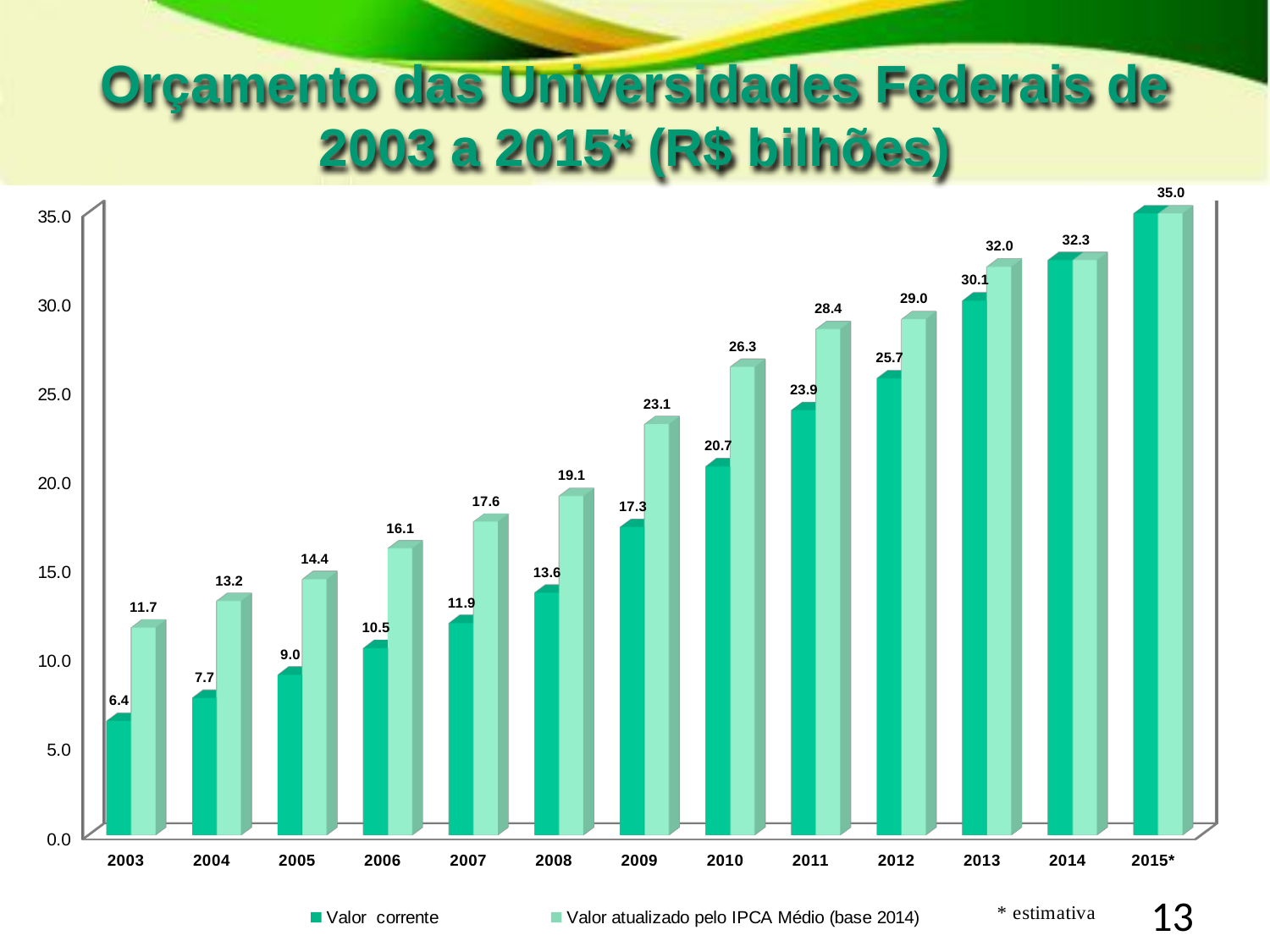
Which year has the highest Valor corrente value? 2015* What is the Valor corrente value for 2003? 6.4 What is the difference between the Valor atualizado pelo IPCA Médio (base 2014) value and the Valor corrente value for 2009? 5.8 Which year has the lowest Valor atualizado pelo IPCA Médio (base 2014) value? 2003 What does the asterisk next to 2015 indicate, according to the note on the slide? estimativa Do the Valor corrente values rise or fall from 2003 to 2015*? rise What is the Valor corrente value for 2013? 30.1 How many years are shown on the x axis? 13 Which is larger in 2006: the Valor corrente value or the Valor atualizado pelo IPCA Médio (base 2014) value? Valor atualizado pelo IPCA Médio (base 2014) How many series does the legend list? 2 What type of chart is shown on the slide? bar chart What is the Valor atualizado pelo IPCA Médio (base 2014) value for 2010? 26.3